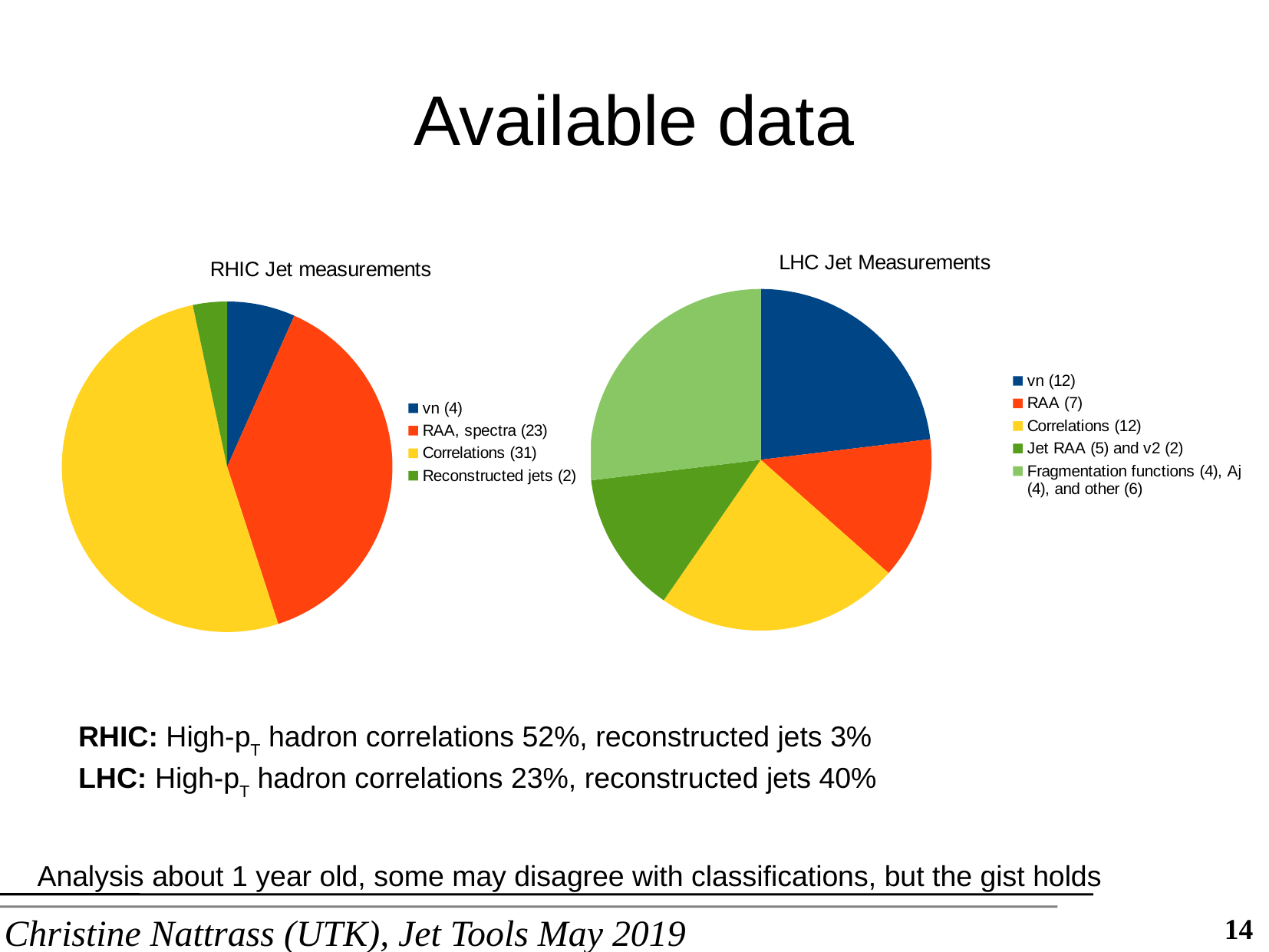
In the LHC Jet Measurements chart, how many measurements are in the vn category? 12 In the RHIC Jet measurements chart, what is the difference between the Correlations count and the RAA, spectra count? 8 In the RHIC Jet measurements chart, which category has the largest slice? Correlations (31) In the RHIC Jet measurements chart, which category has the smallest slice? Reconstructed jets (2) How many categories does the legend of the RHIC Jet measurements chart list? 4 In the RHIC Jet measurements chart, how many measurements are in the RAA, spectra category? 23 In the LHC Jet Measurements chart, which is larger, the vn slice or the RAA slice? vn How many categories does the legend of the LHC Jet Measurements chart list? 5 In the RHIC Jet measurements chart, how many measurements are in the Correlations category? 31 In the LHC Jet Measurements chart, how many measurements are in the RAA category? 7 What type of chart is the RHIC Jet measurements chart? pie chart In the LHC Jet Measurements chart, what colour is the Correlations slice? yellow